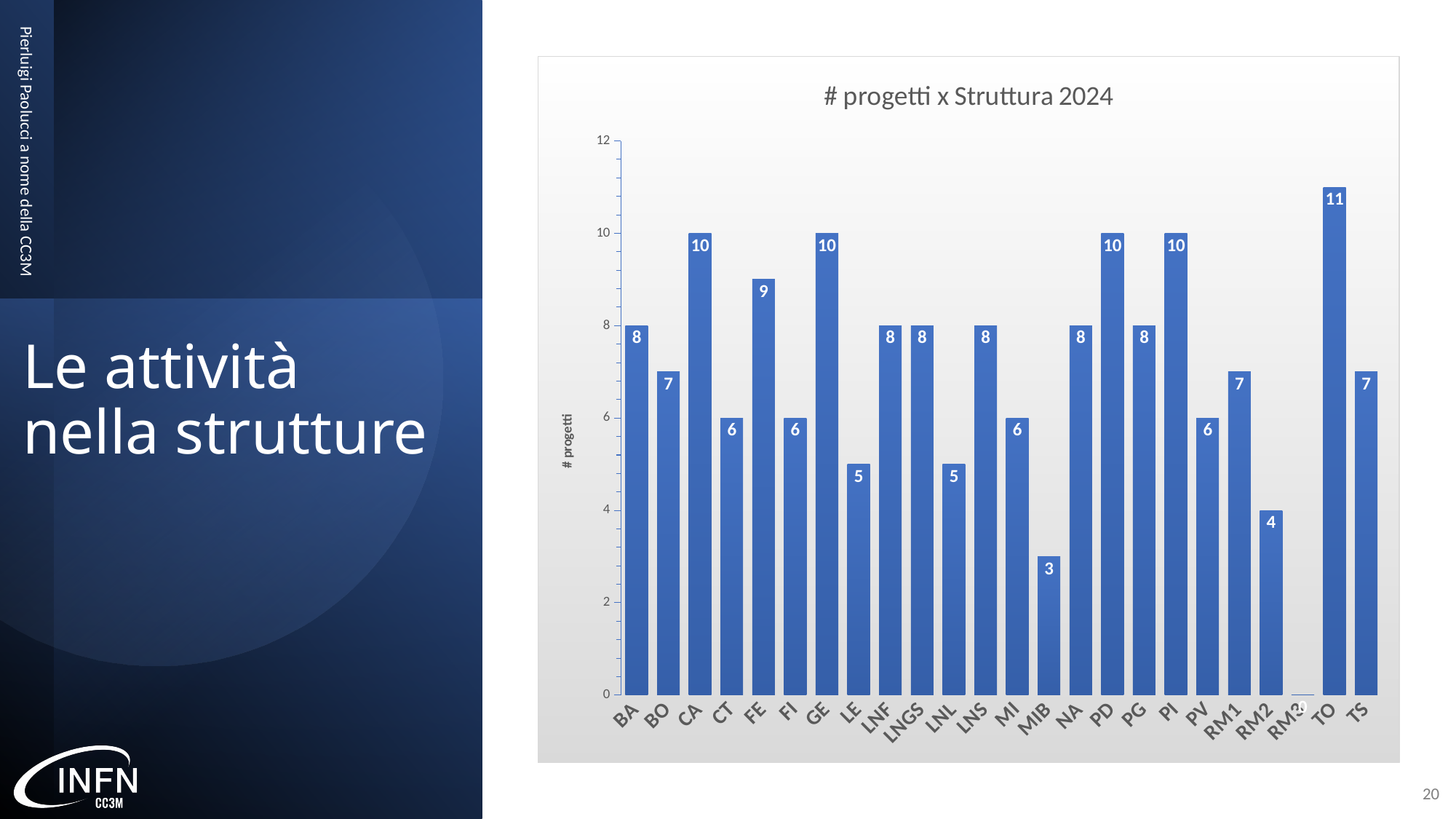
Which structure has the lowest number of projects? RM3 What is the label of the vertical axis? # progetti Which has a higher value, CA or BO? CA What is the difference between the values for PD and PV? 4 How many structures (categories) are shown on the x axis? 24 How many projects does FE have in the chart? 9 What type of chart is shown on the slide? bar chart Which structure has the highest number of projects? TO What is the difference between the values for TO and MIB? 8 What is the title of the chart? # progetti x Struttura 2024 What is the value for MIB? 3 What is the value for RM2? 4